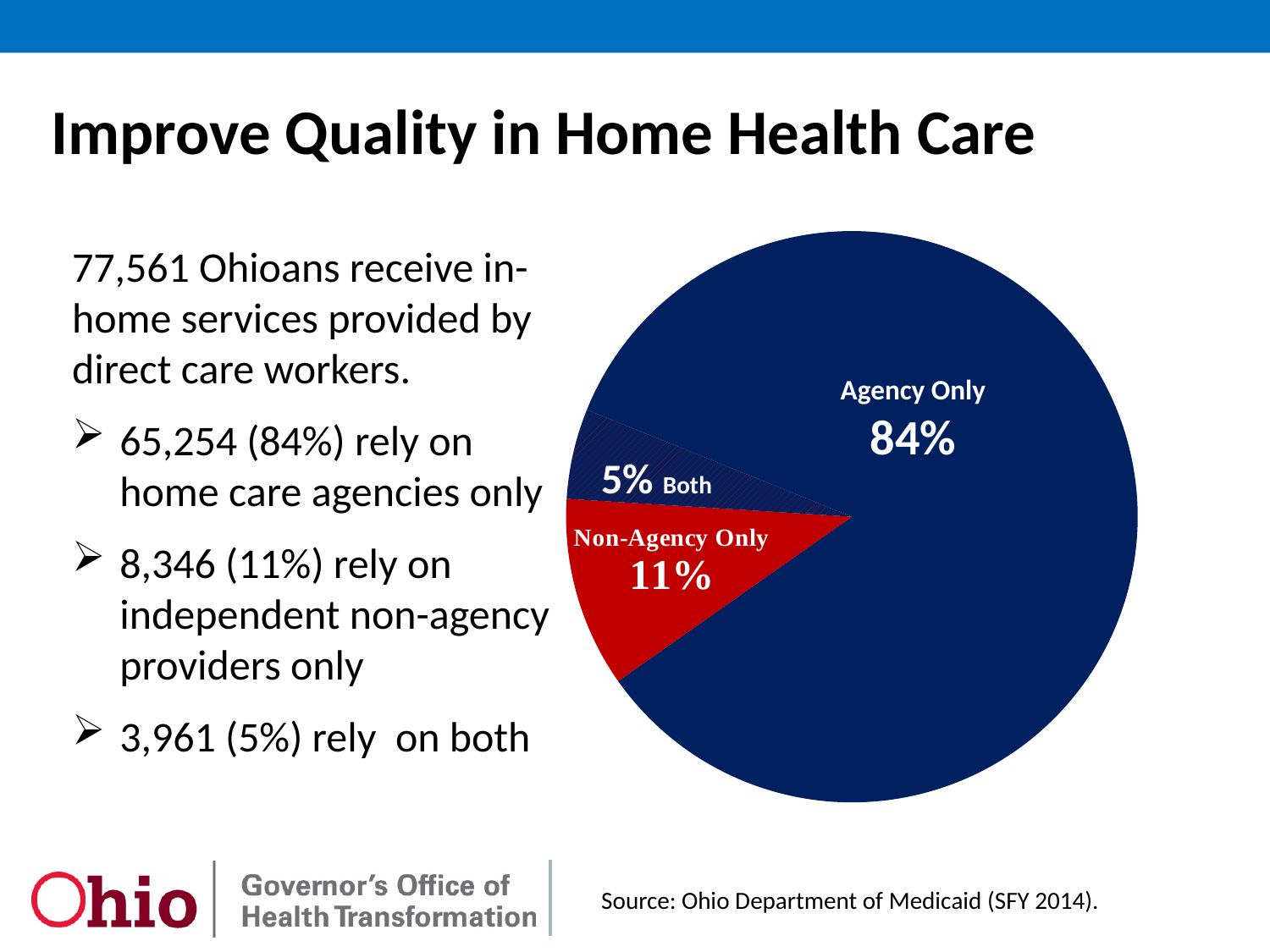
What type of chart is shown on the slide? pie chart What is the title of the slide containing the pie chart? Improve Quality in Home Health Care Which slice is larger, Non-Agency Only or Both? Non-Agency Only What is the difference in percentage points between the Non-Agency Only slice and the Both slice? 6 How many slices does the pie chart have? 3 Which slice of the pie is the largest? Agency Only What share of the pie does Both represent? 5% Which slice of the pie is the smallest? Both What share of the pie does Agency Only represent? 84% What share of the pie does Non-Agency Only represent? 11% What is the difference in percentage points between the Agency Only slice and the Non-Agency Only slice? 73 What colour is the Non-Agency Only slice? red